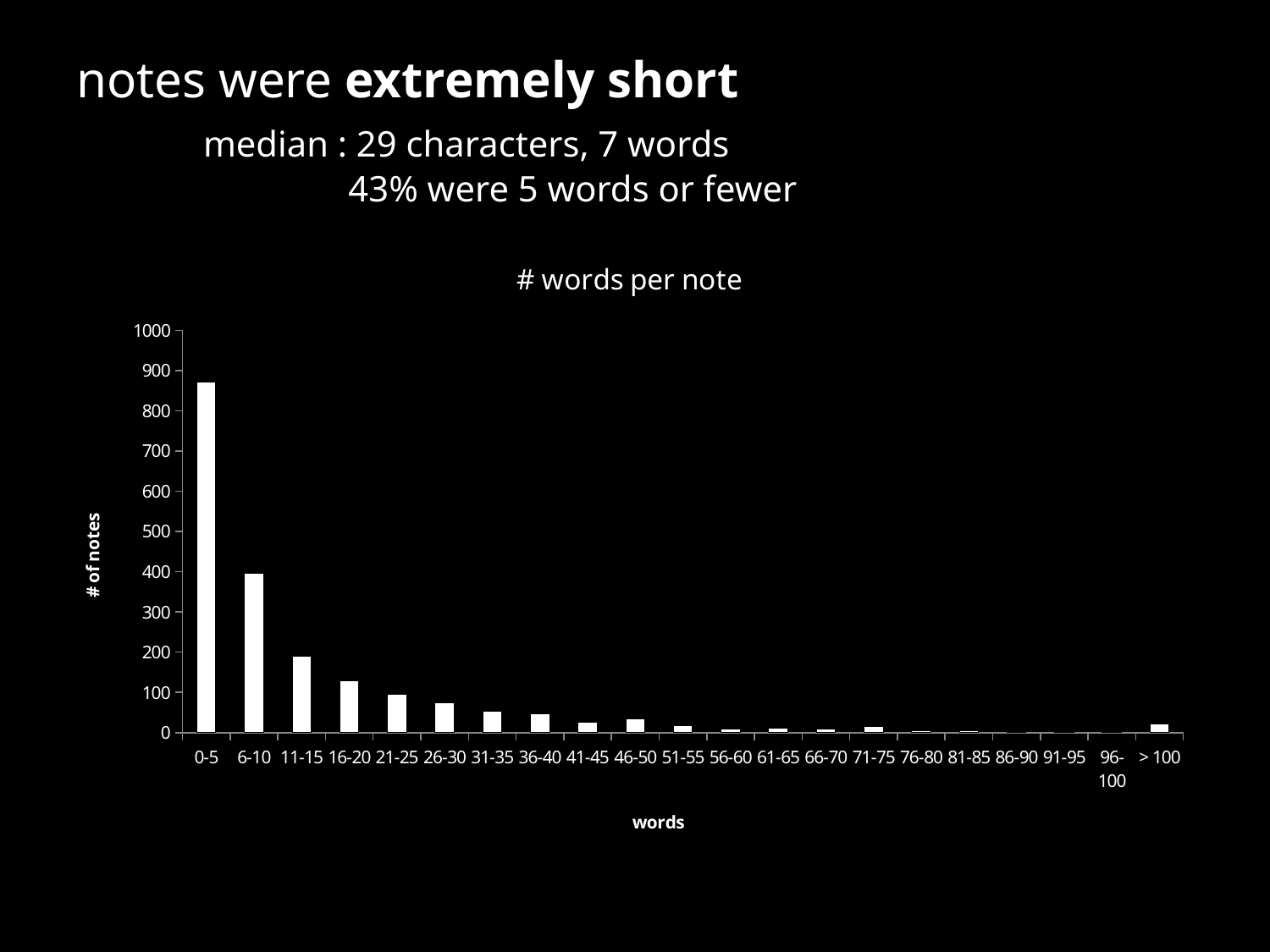
Which has more notes, 6-10 or 16-20? 6-10 Do the values generally rise or fall moving from left to right along the x axis? fall What is the title of the chart? # words per note What is the label of the y axis? # of notes Is the value for 21-25 greater or less than 200? less Is the value for 0-5 greater or less than 800? greater Which has more notes, 0-5 or 11-15? 0-5 Which category has the highest number of notes? 0-5 What kind of chart is shown on the slide? bar chart How many categories are shown on the x axis of the chart? 21 Is the value for 11-15 greater or less than 100? greater